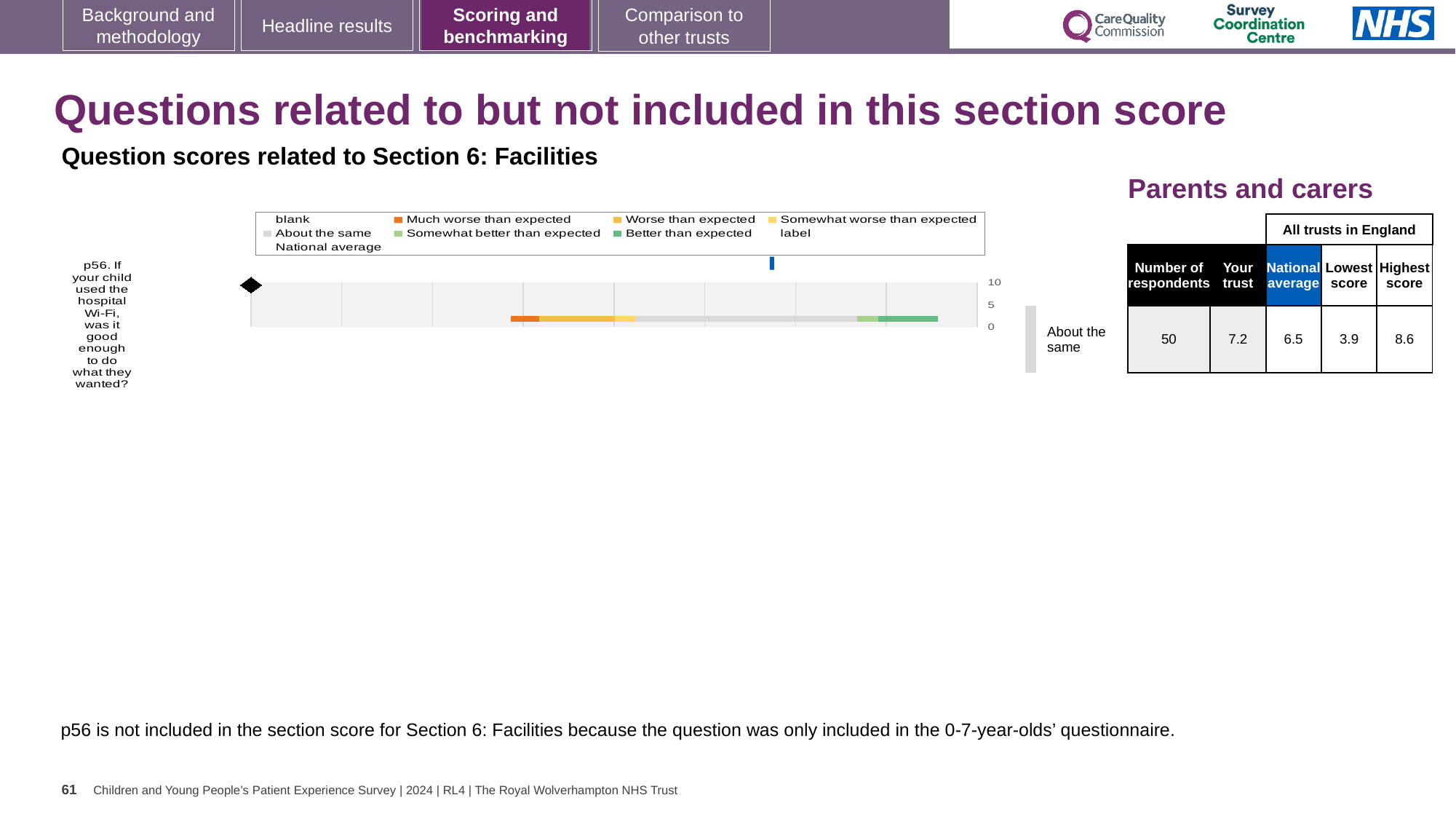
What is the lowest score among all trusts in England for question p56? 3.9 What is the highest score among all trusts in England for question p56? 8.6 What is the difference between the highest and lowest scores among all trusts in England for question p56? 4.7 How many respondents answered question p56? 50 Is the trust's score for question p56 greater or less than 5? greater What is the national average score for question p56? 6.5 What benchmark category is the trust's p56 score placed in? About the same What is the difference between the trust's score and the national average for question p56? 0.7 Which is larger for question p56, the trust's score or the national average? Your trust How many questions are plotted in the chart? 1 What kind of chart is used to show the p56 question score? bar chart What is the score for 'Your trust' on question p56? 7.2